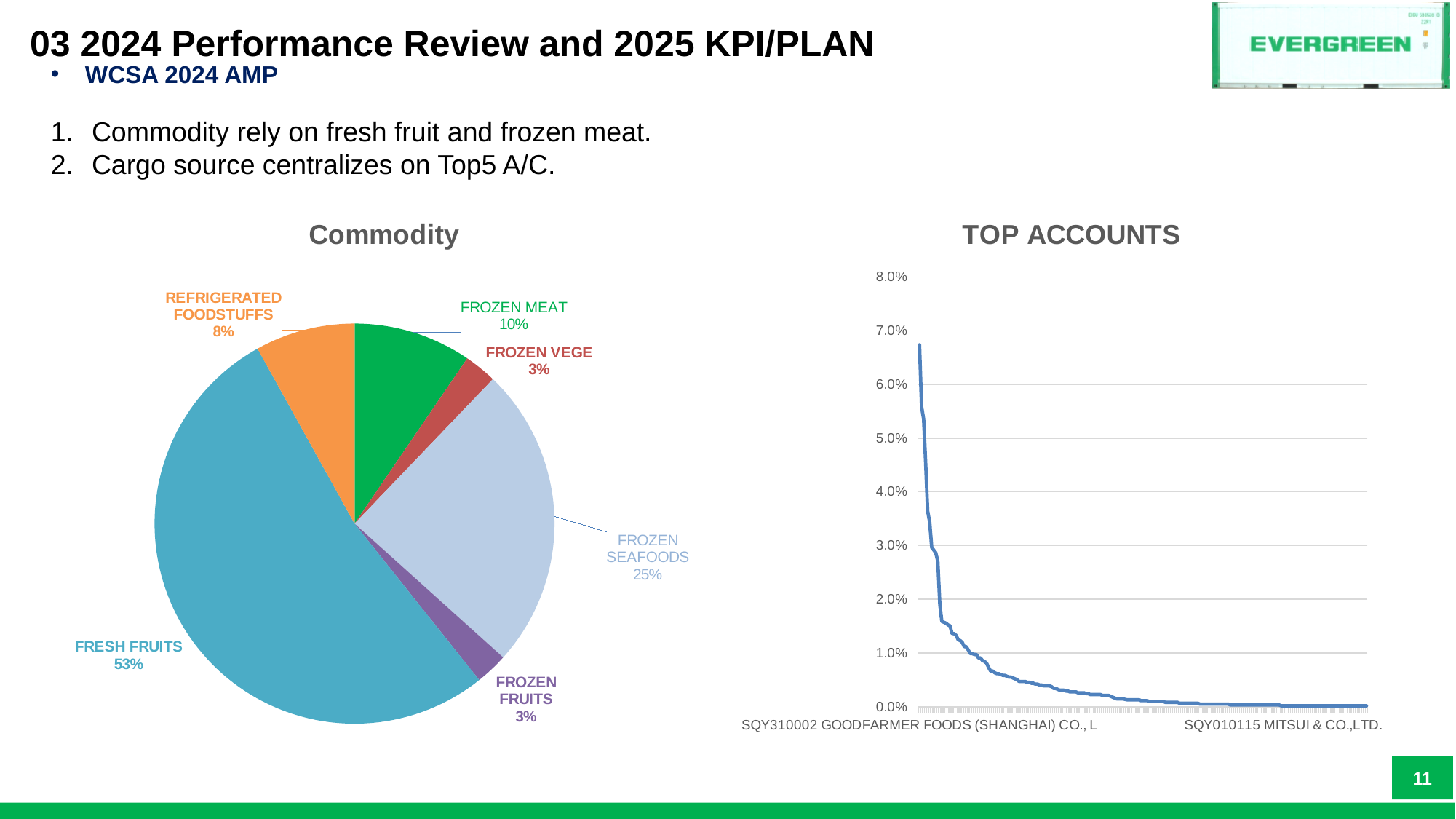
What kind of chart is the Commodity chart? Pie chart In the Commodity pie chart, what share is Fresh Fruits? 53% In the Commodity pie chart, how many slices are there? 6 In the Commodity pie chart, what share is Refrigerated Foodstuffs? 8% In the TOP ACCOUNTS chart, is the value for the first account (SQY310002 GOODFARMER FOODS) greater or less than 6.0%? greater In the Commodity pie chart, which commodity has the largest share? Fresh Fruits In the Commodity pie chart, what share is Frozen Meat? 10% In the Commodity pie chart, what is the difference in percentage points between Fresh Fruits and Frozen Seafoods? 28 percentage points What kind of chart is the TOP ACCOUNTS chart? Line chart In the TOP ACCOUNTS chart, do the values rise or fall from left to right along the x axis? Fall In the Commodity pie chart, which is larger, Frozen Meat or Refrigerated Foodstuffs? Frozen Meat In the Commodity pie chart, what share is Frozen Seafoods? 25%